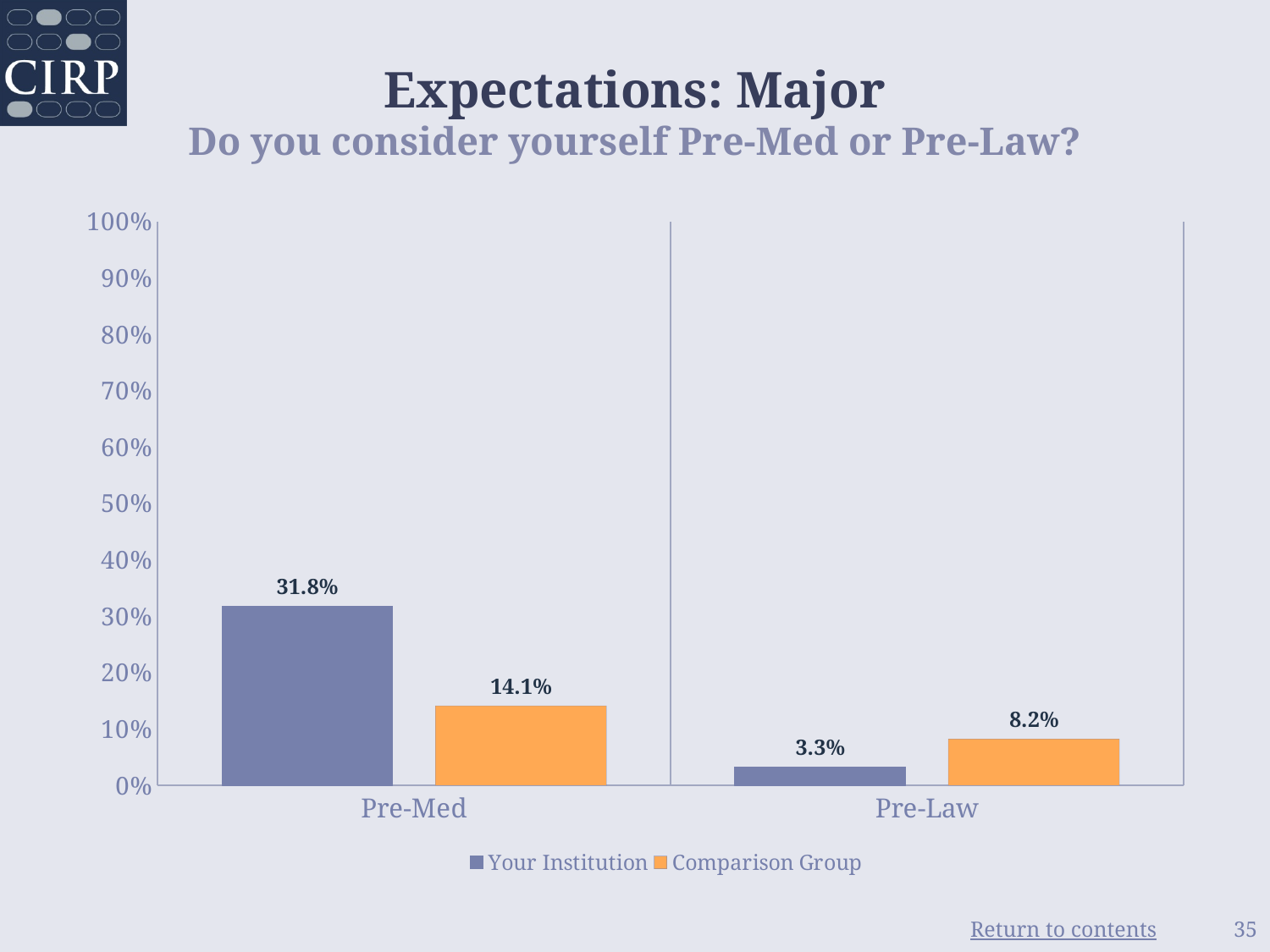
What is the difference between the Comparison Group and Your Institution for Pre-Law? 4.9% For Pre-Law, which is larger: Your Institution or the Comparison Group? Comparison Group How many series does the legend list? 2 What is the Your Institution value for Pre-Law? 3.3% What kind of chart is shown on the slide? Bar chart Which bar on the chart has the lowest value? Your Institution, Pre-Law What is the Comparison Group value for Pre-Med? 14.1% What is the difference between Your Institution and the Comparison Group for Pre-Med? 17.7% What percentage of students at Your Institution consider themselves Pre-Med? 31.8% What is the Comparison Group value for Pre-Law? 8.2% Which bar on the chart has the highest value? Your Institution, Pre-Med What colour are the Comparison Group bars? Orange